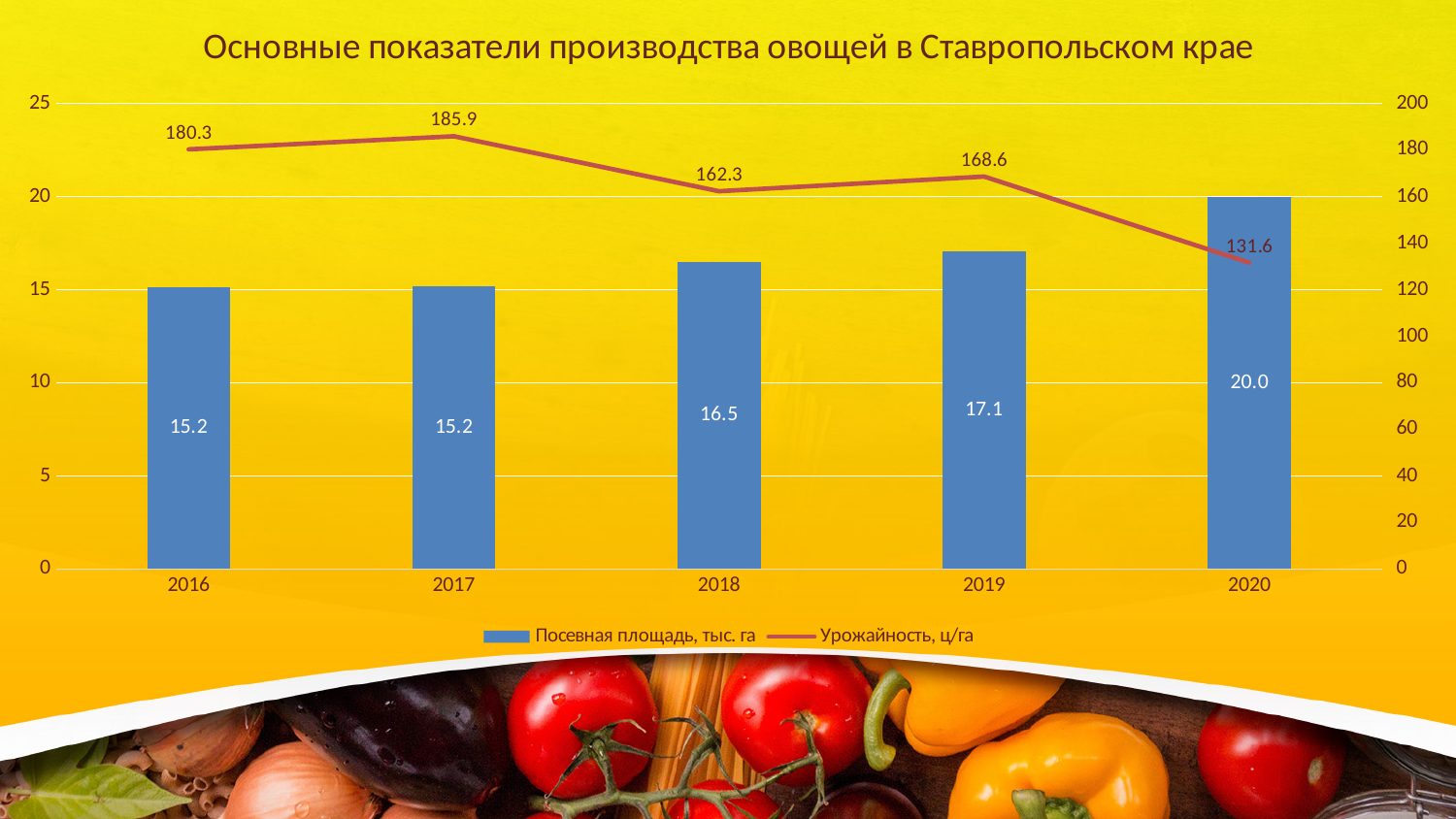
What is the difference in Урожайность, ц/га between 2017 and 2018? 23.6 What is the difference in Посевная площадь, тыс. га between 2020 and 2016? 4.8 What is the value of Посевная площадь, тыс. га for 2018? 16.5 What is the value of Урожайность, ц/га for 2017? 185.9 Which year has the highest Урожайность, ц/га? 2017 Which is larger: Урожайность, ц/га in 2018 or in 2019? 2019 What is the value of Урожайность, ц/га for 2020? 131.6 Does Посевная площадь, тыс. га rise or fall from 2016 to 2020? rise Which year has the lowest Урожайность, ц/га? 2020 How many series does the legend list? 2 How many years are shown on the x axis? 5 Which year has the highest Посевная площадь, тыс. га? 2020